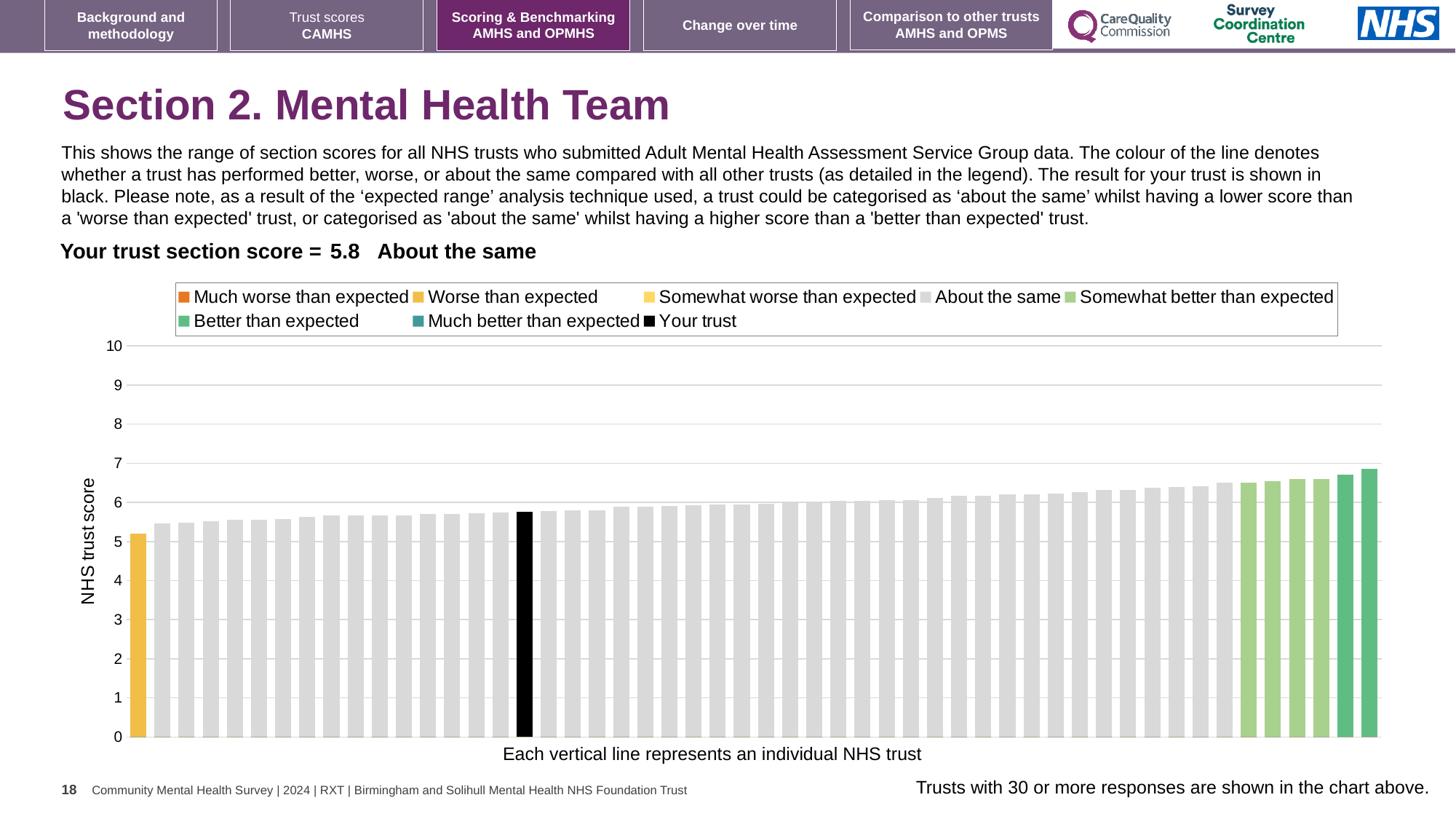
Do the bar values rise or fall from left to right across the chart? Rise Is the value of the black 'Your trust' bar greater or less than 6? less What is your trust's section score for Mental Health Team? 5.8 What colour is used for the 'Your trust' bar in the chart? Black What is the label on the vertical axis of the chart? NHS trust score Which category is your trust placed in for this section? About the same Is the value of the black 'Your trust' bar greater or less than 5? greater Is the value of the rightmost bar greater or less than 6? greater What kind of chart is shown on the slide? Bar chart How many entries does the chart legend list? 8